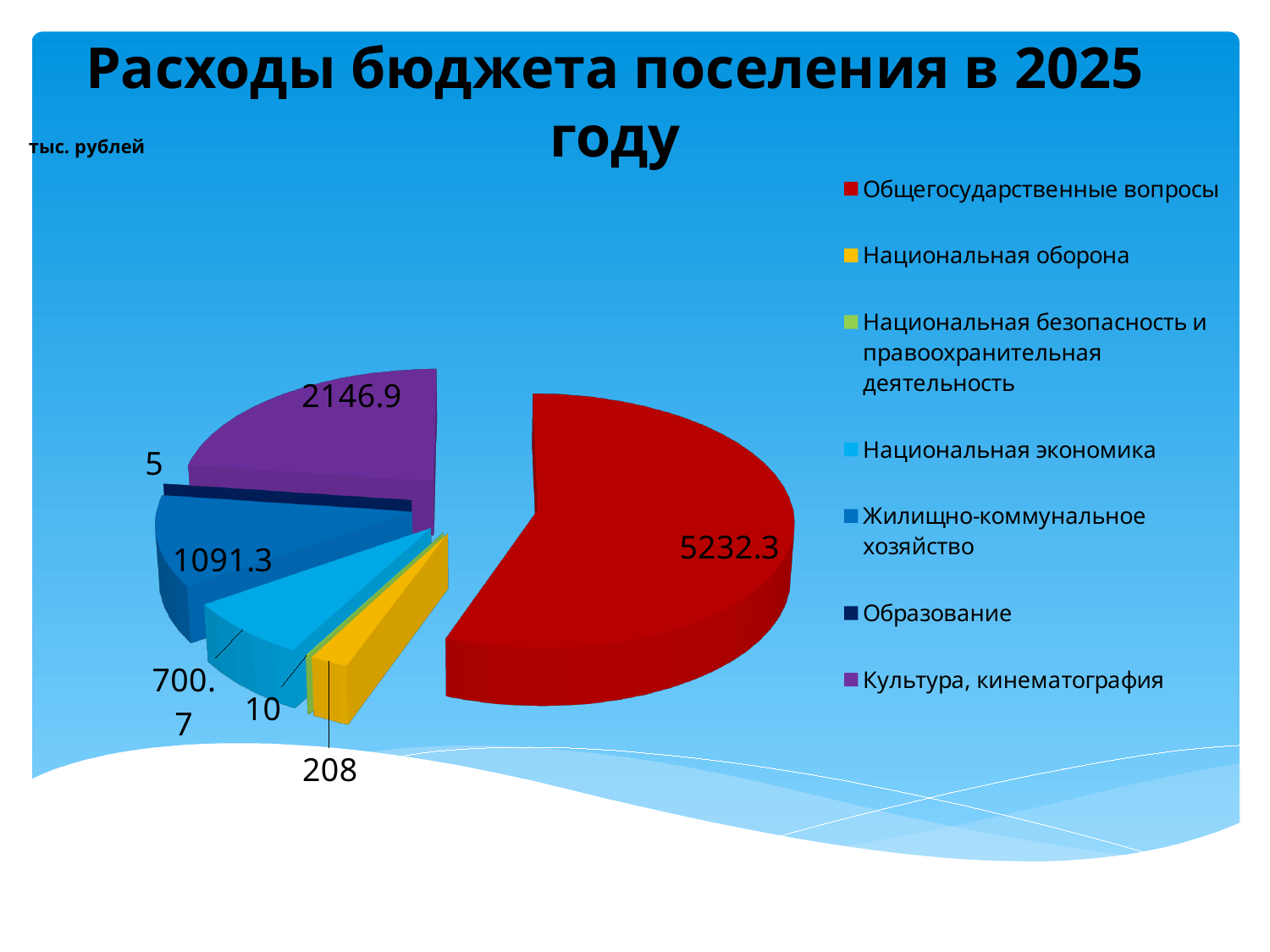
What is the difference between Общегосударственные вопросы and Культура, кинематография? 3085.4 What unit is indicated in the top-left corner of the chart? тыс. рублей What is the value for Образование? 5 Which category has the largest slice? Общегосударственные вопросы How many categories does the pie chart have? 7 What is the value for Жилищно-коммунальное хозяйство? 1091.3 What is the value for Национальная оборона? 208 Which is larger: Жилищно-коммунальное хозяйство or Национальная экономика? Жилищно-коммунальное хозяйство What is the value for Общегосударственные вопросы? 5232.3 What is the value for Культура, кинематография? 2146.9 Which category has the smallest value? Образование What type of chart is shown on the slide? pie chart